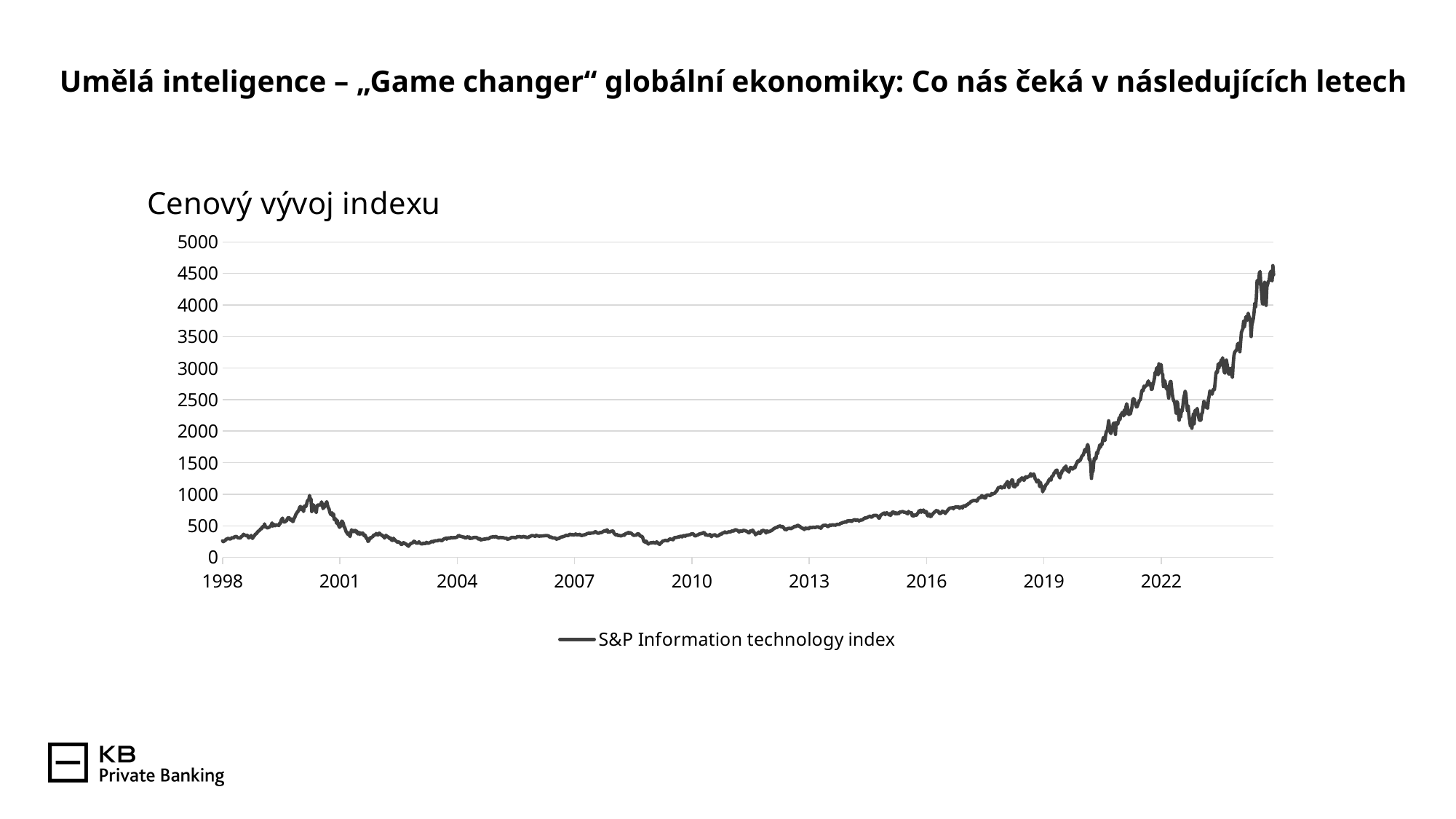
Does the S&P Information technology index overall rise or fall from 1998 to the end of the chart? rise Is the value of the S&P Information technology index at 2022 greater or less than 2000? greater What is the name of the series shown in the legend? S&P Information technology index Is the value of the S&P Information technology index at 2019 greater or less than 500? greater What is the title of the chart? Cenový vývoj indexu Is the value of the S&P Information technology index at 2010 greater or less than 1000? less Which is larger, the value of the S&P Information technology index at 2022 or at 2013? 2022 How many series does the legend list? 1 What kind of chart is shown on the slide? line chart Does the S&P Information technology index rise or fall between 2016 and 2019? rise